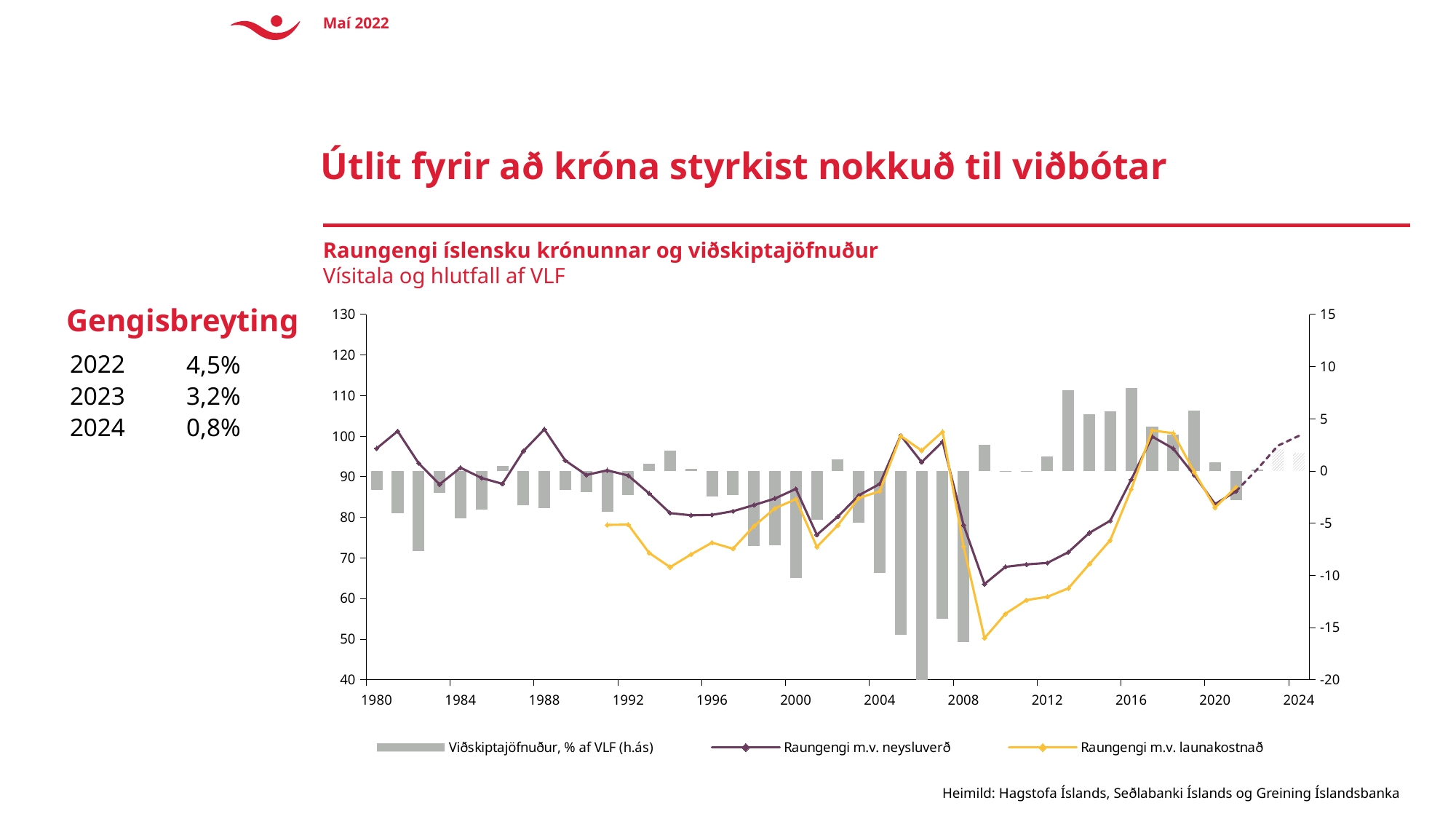
Which series in the chart is plotted as bars? Viðskiptajöfnuður, % af VLF (h.ás) Which is larger: Raungengi m.v. neysluverð in 1980 or in 2009? 1980 Is the value of Raungengi m.v. neysluverð in 2009 greater or less than 70? less In which year does the Raungengi m.v. neysluverð line reach its lowest value? 2009 Is the value of Raungengi m.v. launakostnað in 2009 greater or less than 60? less Does the Raungengi m.v. neysluverð line rise or fall between 2009 and 2017? rise What kind of chart is shown on the slide? A combined bar and line chart What is the title of the chart? Raungengi íslensku krónunnar og viðskiptajöfnuður In which year is the Viðskiptajöfnuður bar at its lowest (most negative)? 2006 Is the Viðskiptajöfnuður bar for 2013 greater or less than 5 on the right axis? greater How many series does the chart legend list? 3 In which year does the Raungengi m.v. launakostnað line reach its lowest value? 2009